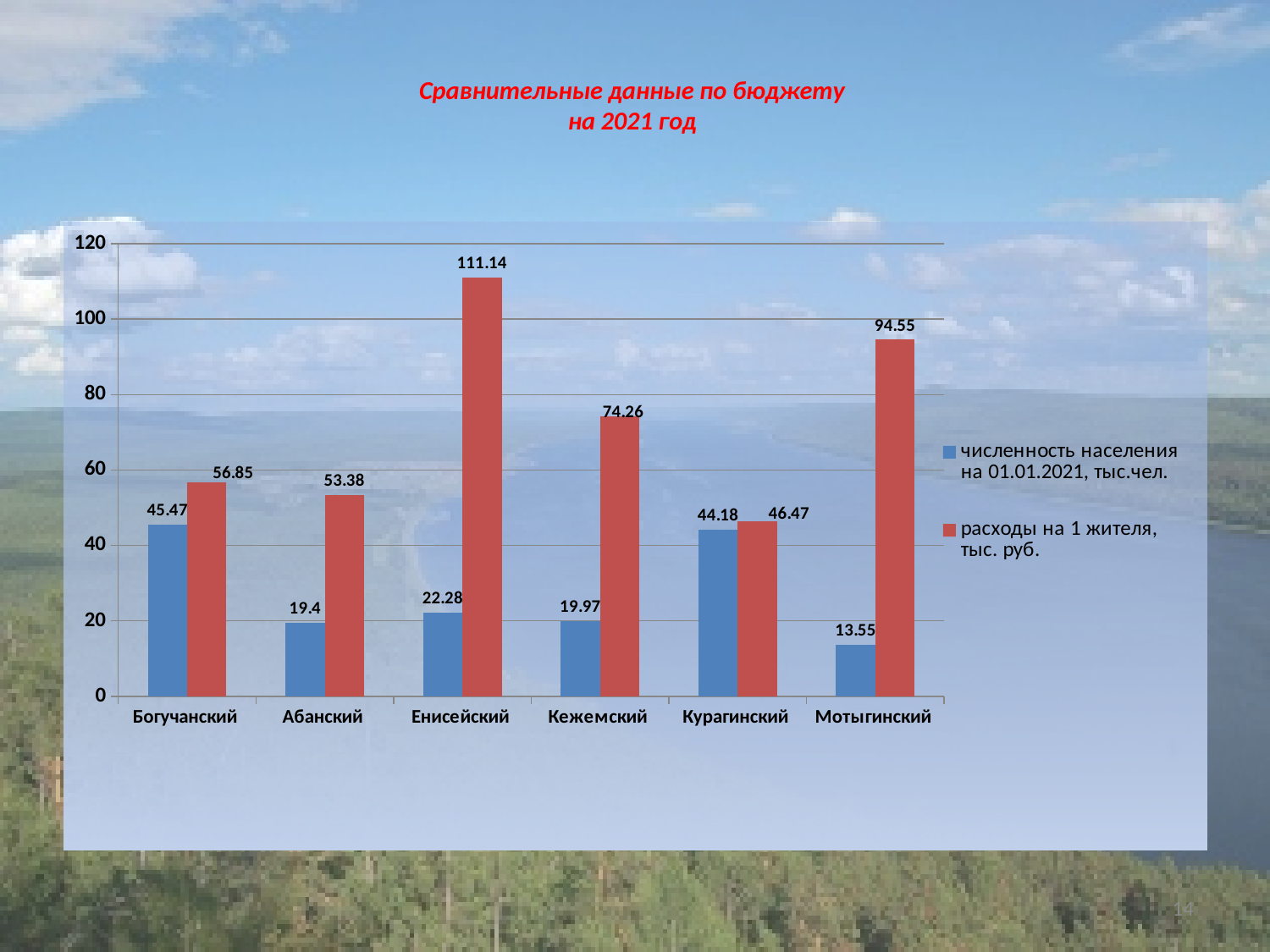
Is the value of расходы на 1 жителя for Кежемский greater or less than 60? greater What is the value of расходы на 1 жителя, тыс. руб. for Мотыгинский? 94.55 What kind of chart is shown on the slide? bar chart What is the value of расходы на 1 жителя, тыс. руб. for Енисейский? 111.14 How many districts are shown on the x axis? 6 What is the difference between расходы на 1 жителя for Енисейский and for Мотыгинский? 16.59 What colour are the bars for расходы на 1 жителя, тыс. руб.? red Which district has the highest расходы на 1 жителя, тыс. руб.? Енисейский Which is larger: the population of Богучанский or the population of Курагинский? Богучанский Which district has the lowest численность населения на 01.01.2021, тыс.чел.? Мотыгинский What is the population (численность населения на 01.01.2021, тыс.чел.) for Богучанский? 45.47 How many series does the legend list? 2